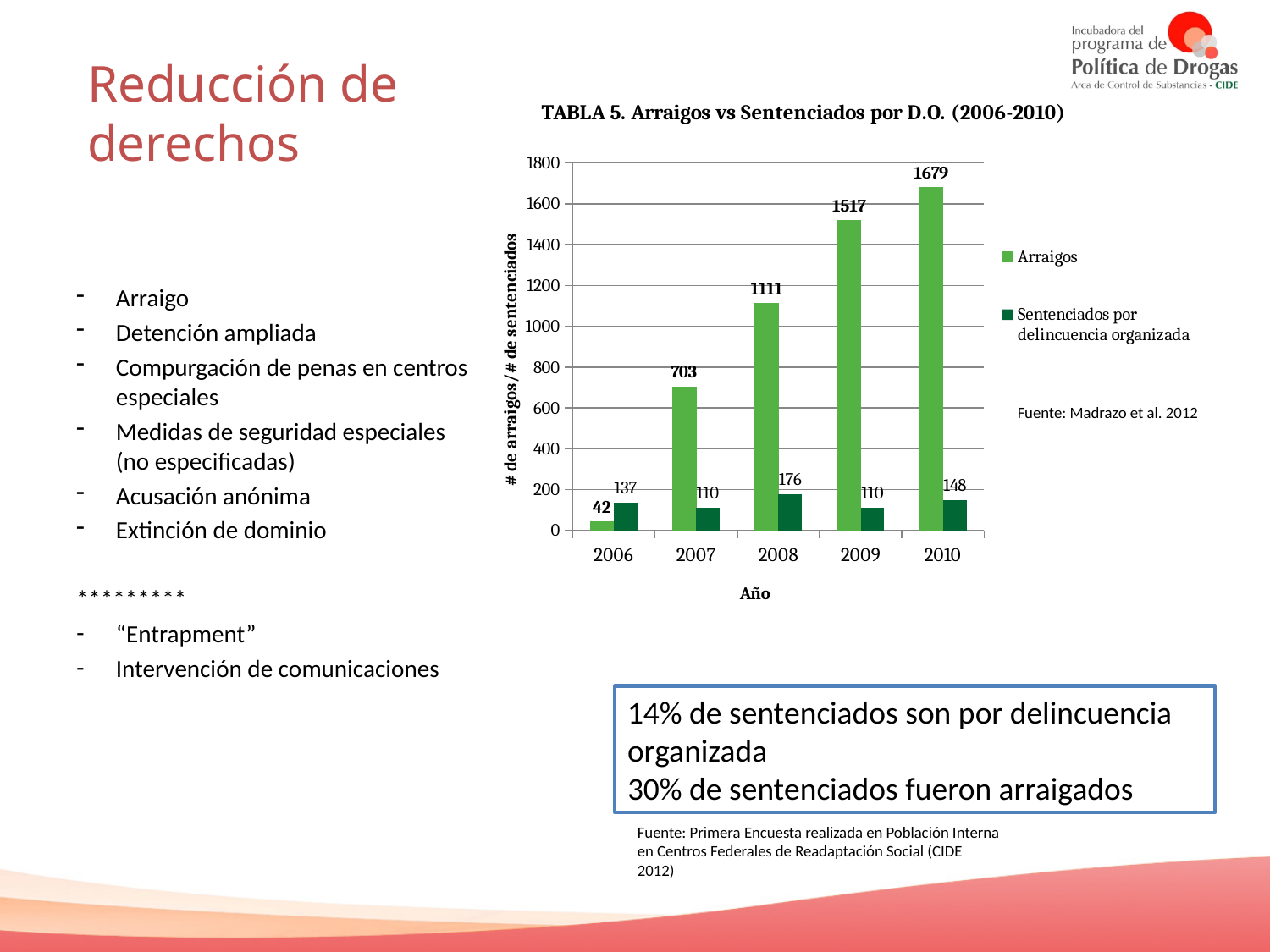
What is the title of the chart? TABLA 5. Arraigos vs Sentenciados por D.O. (2006-2010) How many series does the legend list? 2 How many years are shown on the x axis? 5 Which year has the highest value for Arraigos? 2010 Do the Arraigos values rise or fall from 2006 to 2010? Rise What is the value of Arraigos for 2006? 42 What is the value of Arraigos for 2010? 1679 What kind of chart is shown? Bar chart Which year has the lowest value for Sentenciados por delincuencia organizada? 2007 and 2009 Which is larger in 2006: Arraigos or Sentenciados por delincuencia organizada? Sentenciados por delincuencia organizada What is the difference between Arraigos in 2010 and Arraigos in 2009? 162 What is the value of Sentenciados por delincuencia organizada for 2008? 176